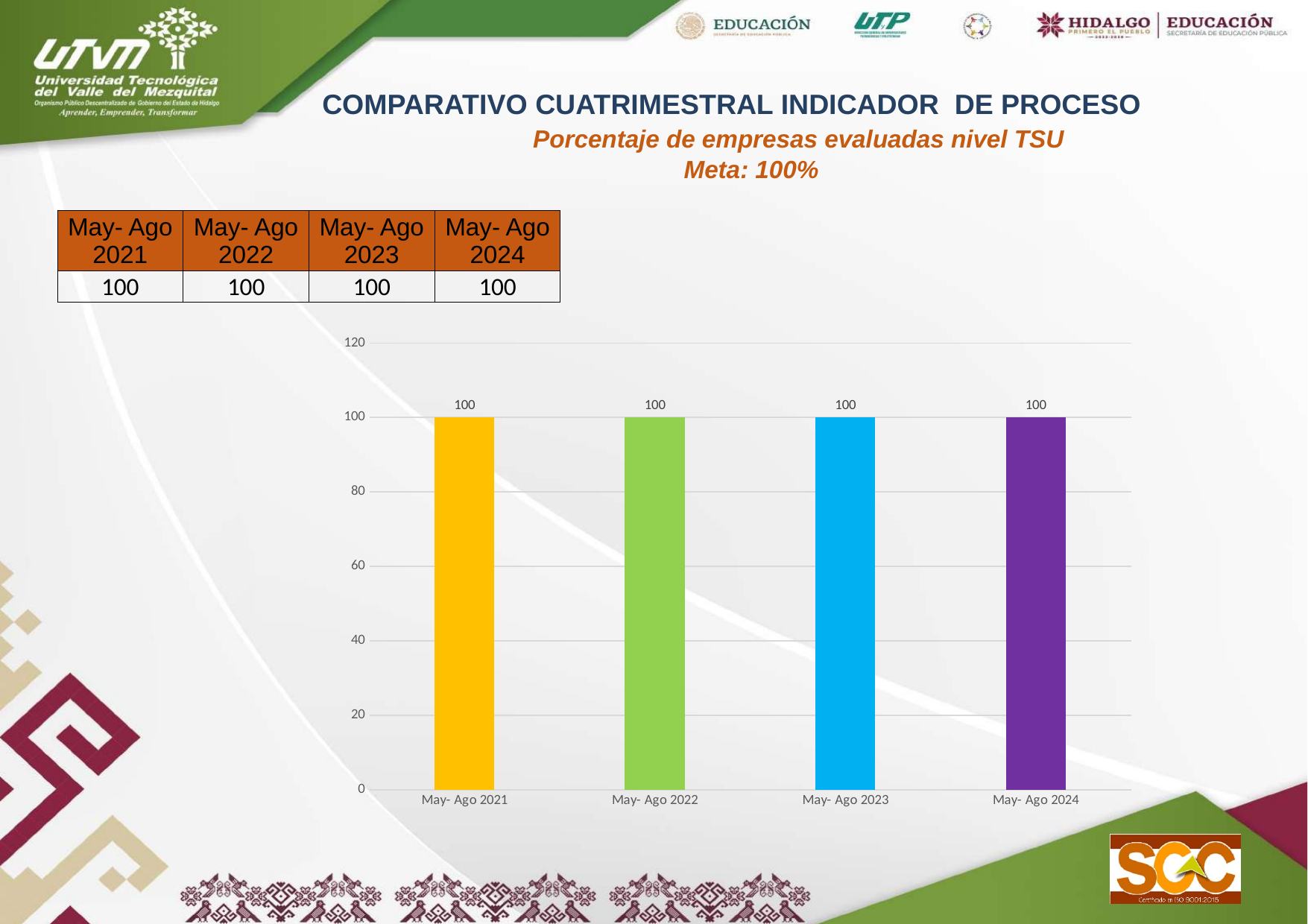
What is the value for May- Ago 2022? 100 What colour is the bar for May- Ago 2022? green What is the difference between the values for May- Ago 2024 and May- Ago 2021? 0 What kind of chart is shown on the slide? bar chart What is the value for May- Ago 2023? 100 What is the highest tick value shown on the vertical axis? 120 Do the values rise, fall or stay constant from May- Ago 2021 to May- Ago 2024? stay constant What is the value for May- Ago 2021? 100 Is the value for May- Ago 2023 greater or less than 80? greater What is the value for May- Ago 2024? 100 How many bars are plotted in the chart? 4